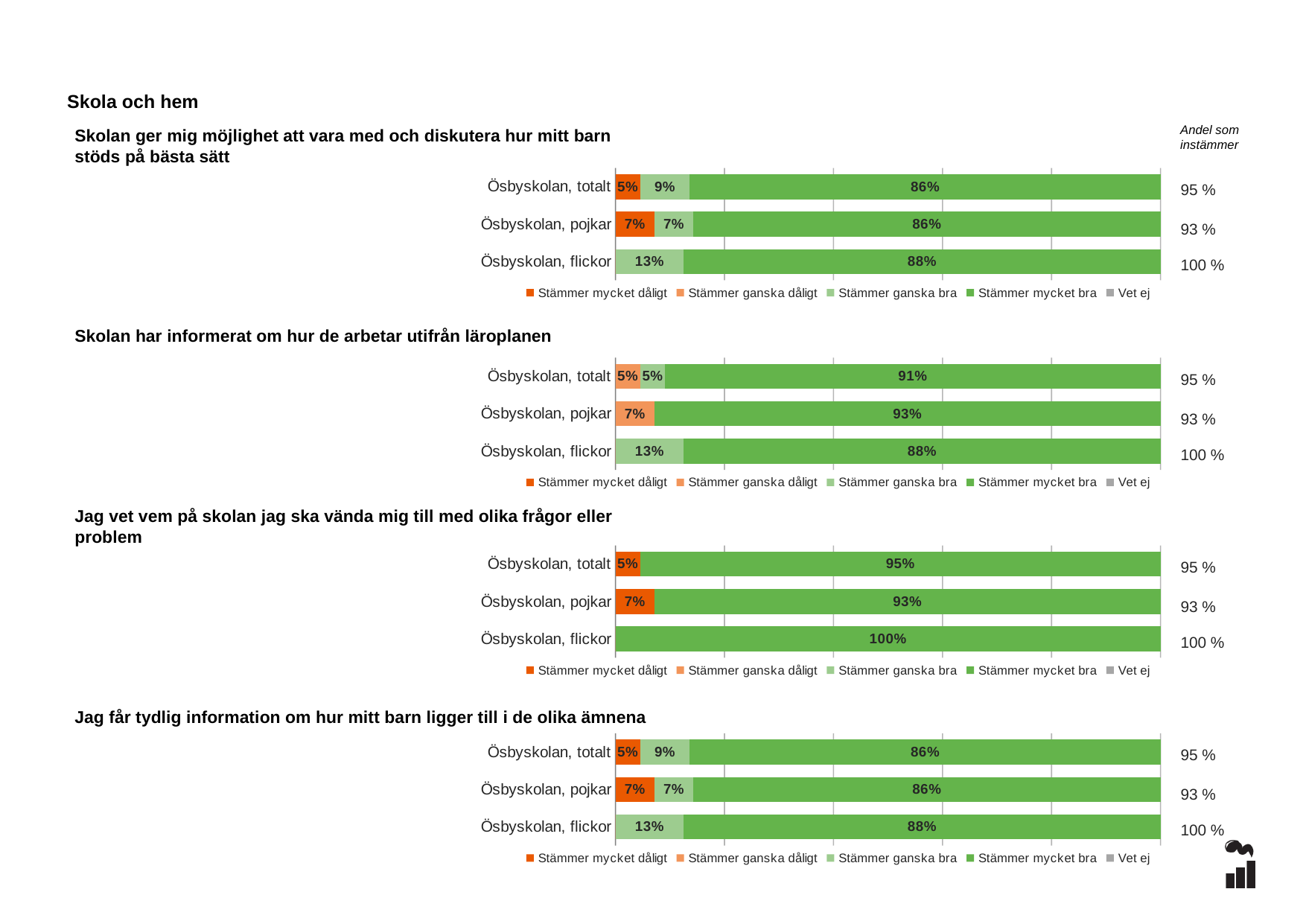
In the chart 'Jag får tydlig information om hur mitt barn ligger till i de olika ämnena', what is the 'Stämmer mycket dåligt' value for Ösbyskolan, pojkar? 7% What kind of chart is 'Skolan har informerat om hur de arbetar utifrån läroplanen'? Stacked bar chart How many categories are shown in the chart 'Jag får tydlig information om hur mitt barn ligger till i de olika ämnena'? 3 In the chart 'Skolan har informerat om hur de arbetar utifrån läroplanen', what is the difference between the 'Stämmer mycket bra' values for Ösbyskolan, pojkar and Ösbyskolan, flickor? 5% In the chart 'Skolan ger mig möjlighet att vara med och diskutera hur mitt barn stöds på bästa sätt', what is the 'Stämmer ganska bra' value for Ösbyskolan, flickor? 13% How many series does the legend list for the chart 'Skolan ger mig möjlighet att vara med och diskutera hur mitt barn stöds på bästa sätt'? 5 In the chart 'Skolan har informerat om hur de arbetar utifrån läroplanen', what is the 'Stämmer mycket bra' value for Ösbyskolan, totalt? 91% In the chart 'Jag får tydlig information om hur mitt barn ligger till i de olika ämnena', what is the 'Andel som instämmer' value shown for Ösbyskolan, flickor? 100 % In the chart 'Jag vet vem på skolan jag ska vända mig till med olika frågor eller problem', what is the 'Stämmer mycket bra' value for Ösbyskolan, flickor? 100% In the chart 'Jag vet vem på skolan jag ska vända mig till med olika frågor eller problem', which category has the lowest 'Stämmer mycket bra' value? Ösbyskolan, pojkar In the chart 'Jag vet vem på skolan jag ska vända mig till med olika frågor eller problem', which is larger: the 'Stämmer mycket dåligt' value for Ösbyskolan, totalt or for Ösbyskolan, pojkar? Ösbyskolan, pojkar In the chart 'Skolan har informerat om hur de arbetar utifrån läroplanen', which category has the highest 'Stämmer mycket bra' value? Ösbyskolan, pojkar